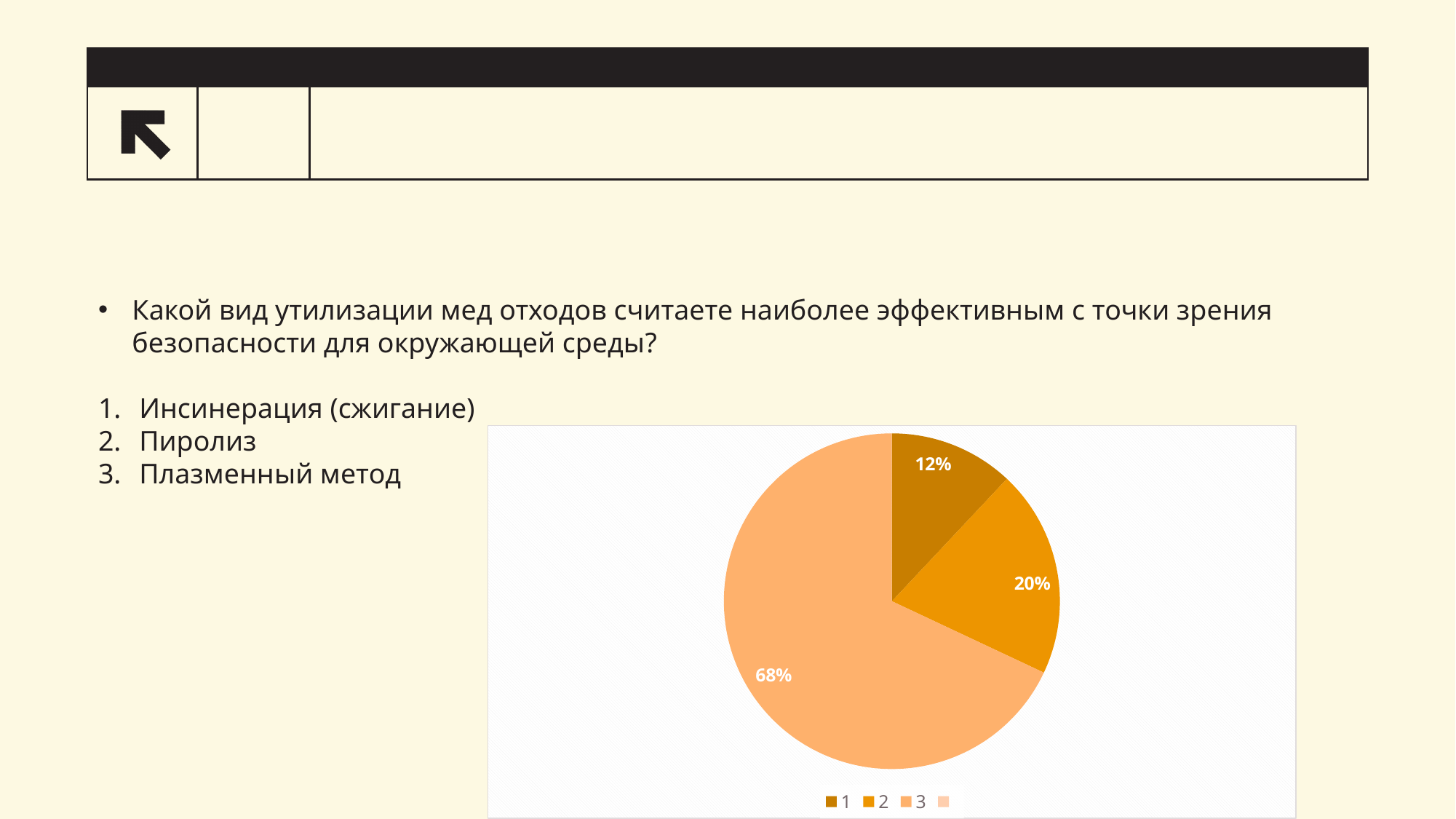
What is the difference in percentage points between category 3 and category 2? 48 How many labelled slices does the pie chart have? 3 What percentage is shown for category 2 in the pie chart? 20% Which category is shown in the darkest orange colour in the pie chart? 1 Which is larger, the slice for category 1 or the slice for category 2? 2 What is the difference in percentage points between category 2 and category 1? 8 What kind of chart is shown on the slide? pie chart What do the three labelled slices of the pie chart add up to? 100% What percentage is shown for category 3 in the pie chart? 68% Which category has the smallest slice in the pie chart? 1 What percentage is shown for category 1 in the pie chart? 12% Which category has the largest slice in the pie chart? 3